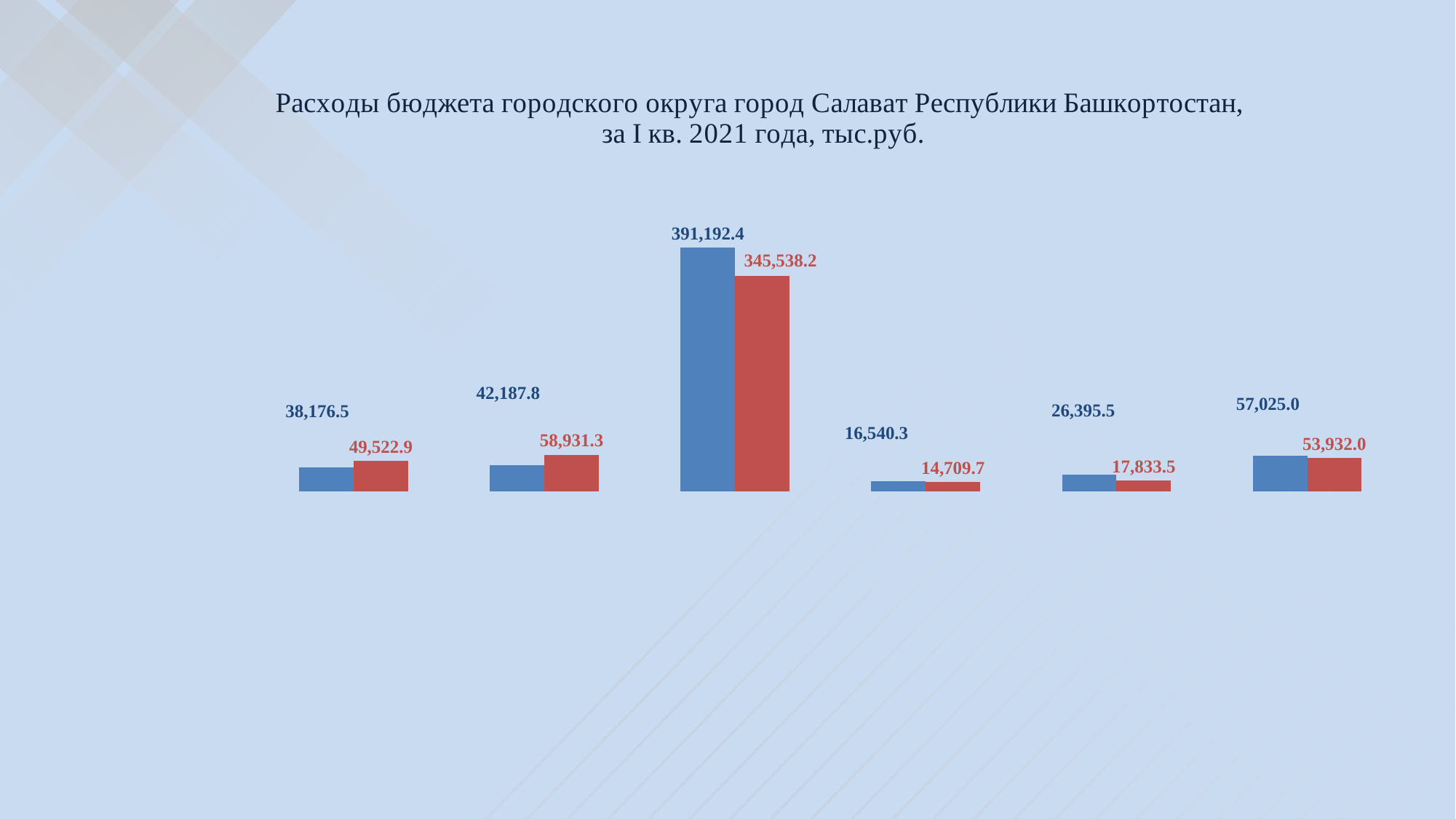
What is the lowest value among the red bars? 14,709.7 What unit of measurement is stated in the chart title? тыс.руб. What is the value of the blue bar in the sixth group from the left? 57,025.0 What kind of chart is shown on the slide? bar chart How many groups of bars are plotted in the chart? 6 In the third group from the left, what is the difference between the blue bar and the red bar? 45,654.2 What is the value of the red bar in the first group from the left? 49,522.9 In the first group from the left, which bar is larger, the blue one or the red one? the red one What is the value of the blue bar in the third group from the left? 391,192.4 Which group has the highest blue bar, and what is its value? The third group, 391,192.4 How many data series (bar colours) are plotted in the chart? 2 What is the value of the red bar in the third group from the left? 345,538.2